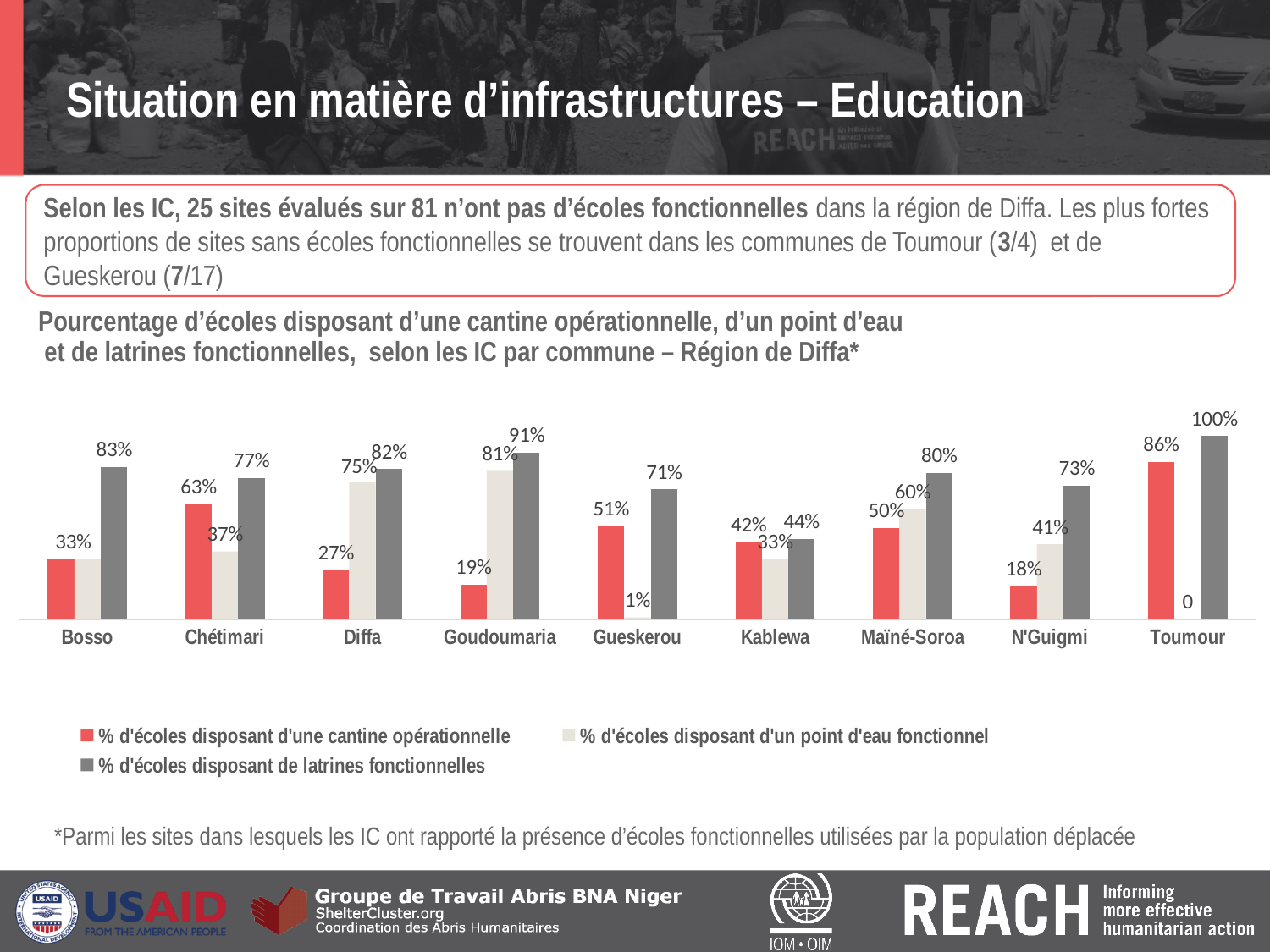
In Chétimari, what is the difference between the percentage of schools with functional latrines and the percentage with an operational canteen? 14 percentage points How many series does the chart's legend list? 3 Which colour represents '% d'écoles disposant d'une cantine opérationnelle' in the chart? Red What is the value for '% d'écoles disposant d'un point d'eau fonctionnel' in Maïné-Soroa? 60% How many communes are shown on the x axis of the chart? 9 What kind of chart is shown on the slide? Bar chart What is the value for '% d'écoles disposant d'une cantine opérationnelle' in Toumour? 86% In Diffa, which is larger: the percentage of schools with an operational canteen or the percentage with a functional water point? % d'écoles disposant d'un point d'eau fonctionnel What percentage of schools in Goudoumaria have functional latrines (% d'écoles disposant de latrines fonctionnelles)? 91% Which commune has the highest value for '% d'écoles disposant de latrines fonctionnelles'? Toumour Which commune has the lowest value for '% d'écoles disposant d'une cantine opérationnelle'? N'Guigmi What is the value for '% d'écoles disposant d'un point d'eau fonctionnel' in Gueskerou? 1%